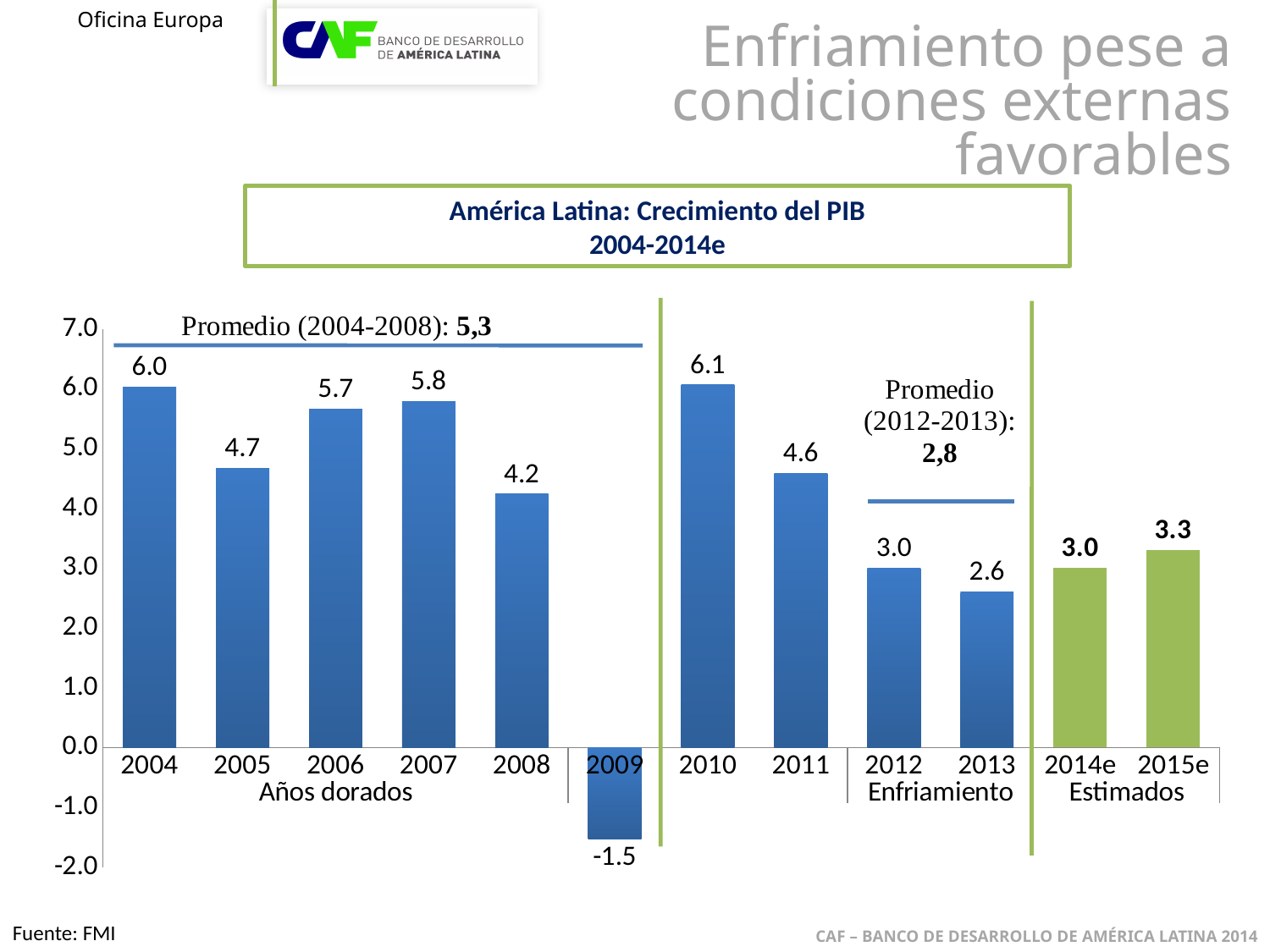
What is the value shown for 2009? -1.5 What is the value shown for 2015e? 3.3 How many years (bars) are plotted on the chart? 12 Which is larger, the value for 2006 or the value for 2007? 2007 What is the difference between the values for 2010 and 2011? 1.5 What is the difference between the values for 2012 and 2013? 0.4 What is the average (Promedio) shown for 2004-2008? 5,3 Is the value for 2008 greater or less than 4.0? greater What type of chart is shown on the slide? Bar chart Which year has the lowest value on the chart? 2009 Which year has the highest GDP growth value on the chart? 2010 What is the GDP growth value shown for 2004? 6.0